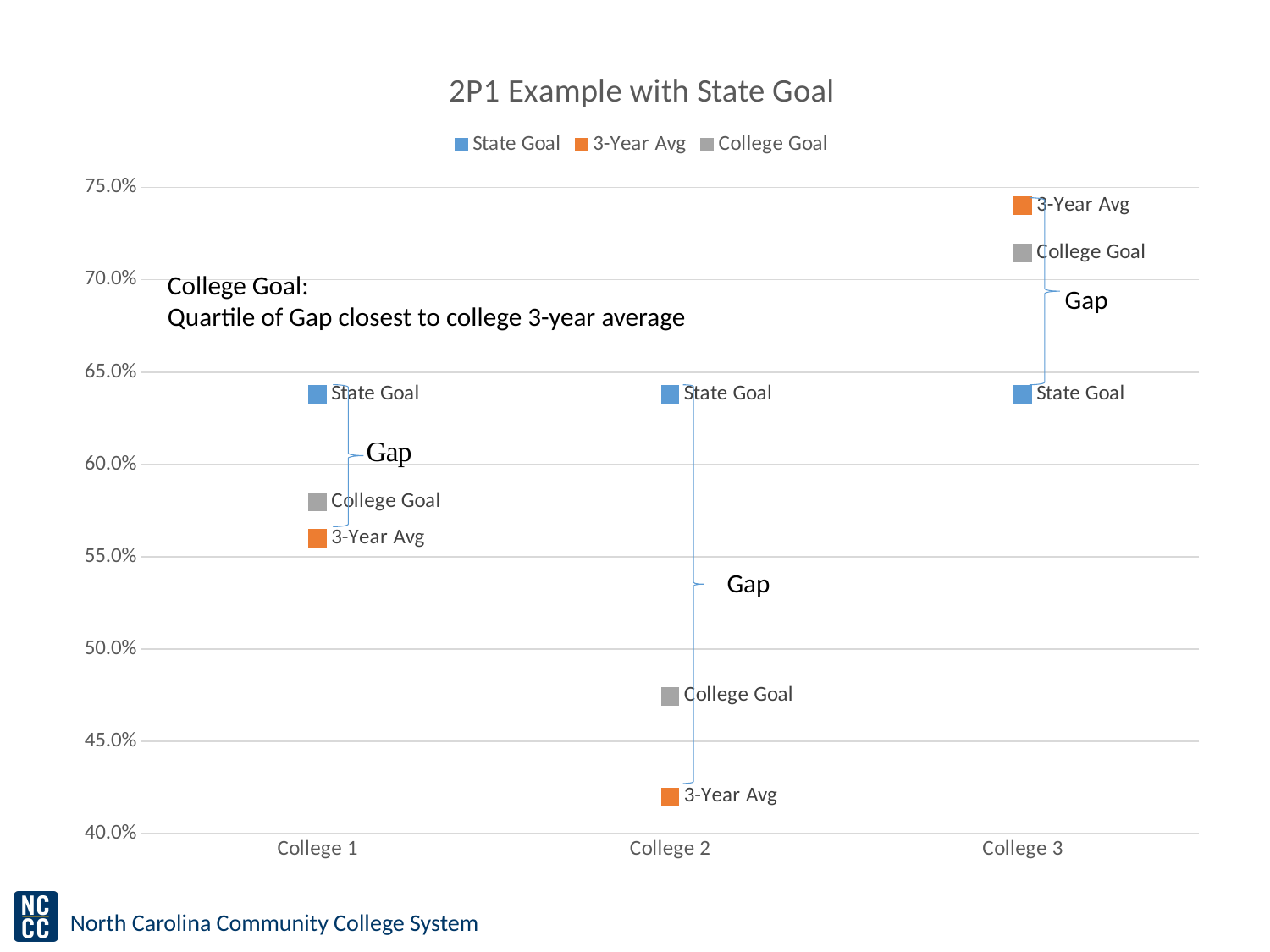
Is the College Goal value for College 2 greater or less than 50.0%? less For College 3, which is larger: the 3-Year Avg or the State Goal? 3-Year Avg Which college has the highest College Goal? College 3 Is the 3-Year Avg value for College 2 greater or less than 45.0%? less Which college has the lowest 3-Year Avg? College 2 Is the College Goal value for College 1 greater or less than 60.0%? less How many colleges are shown on the x axis? 3 What is the title of the chart? 2P1 Example with State Goal How many series does the legend list? 3 Which colour represents the 3-Year Avg series in the legend? Orange